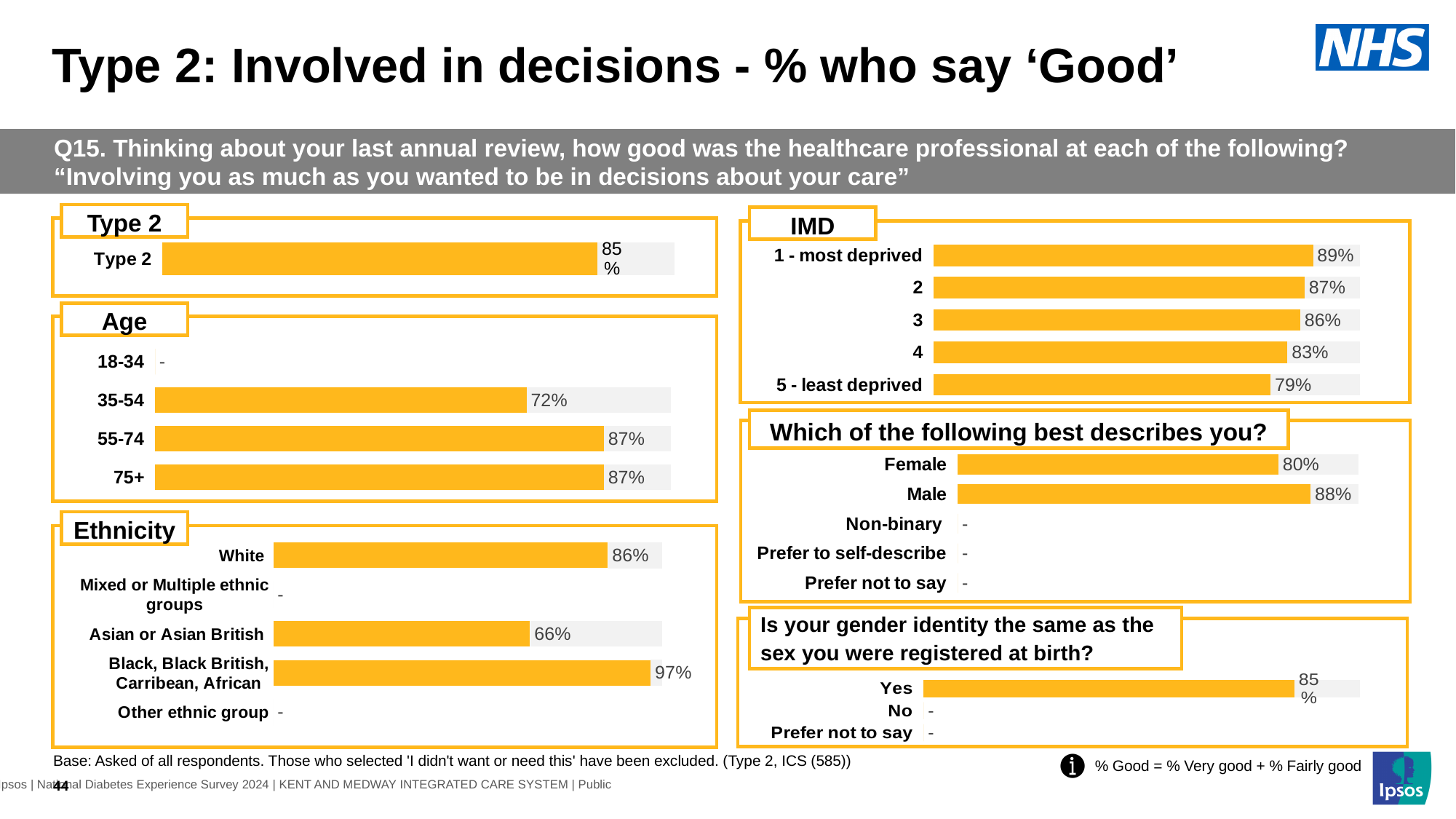
In the Age chart, which age group has the lowest value among those with a bar shown? 35-54 In the 'Is your gender identity the same as the sex you were registered at birth?' chart, what is the value for Yes? 85% In the Type 2 chart, what is the value for Type 2? 85% In the IMD chart, what is the value for 5 - least deprived? 79% In the 'Which of the following best describes you?' chart, which is larger, Female or Male? Male In the Ethnicity chart, what is the value for Asian or Asian British? 66% In the 'Which of the following best describes you?' chart, what is the difference between Male and Female? 8 percentage points In the IMD chart, do the values rise or fall from 1 - most deprived to 5 - least deprived? fall In the Age chart, what is the value for 35-54? 72% In the Ethnicity chart, what is the difference between the values for White and Asian or Asian British? 20 percentage points In the Ethnicity chart, which ethnic group has the highest value? Black, Black British, Carribean, African In the IMD chart, which IMD group has the highest value? 1 - most deprived